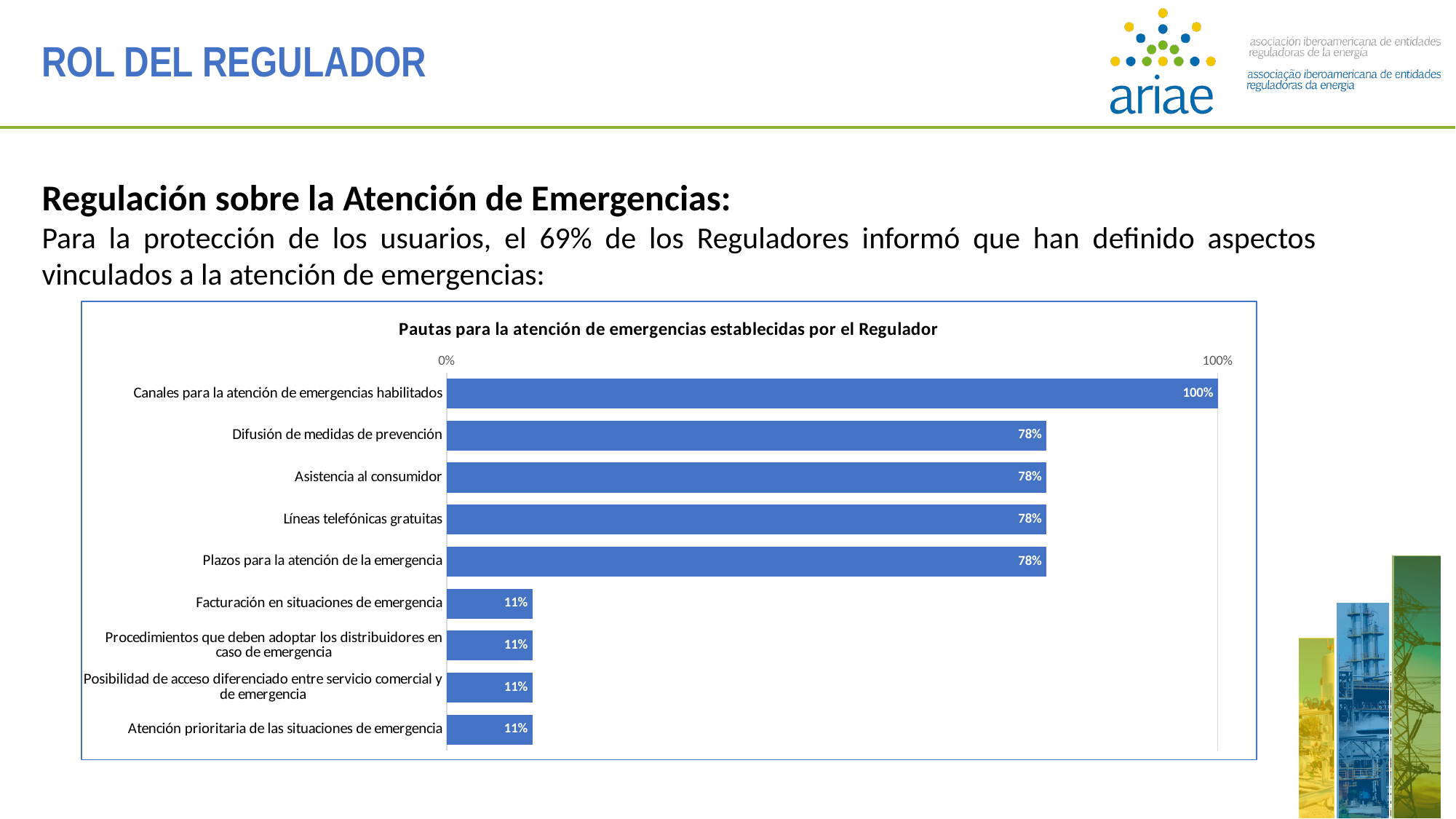
What is the value for "Canales para la atención de emergencias habilitados"? 100% How many categories have a value of 11%? 4 What is the title of the chart? Pautas para la atención de emergencias establecidas por el Regulador What is the value for "Facturación en situaciones de emergencia"? 11% What is the difference between the values for "Líneas telefónicas gratuitas" and "Atención prioritaria de las situaciones de emergencia"? 67% Which category has the highest value? Canales para la atención de emergencias habilitados How many categories are shown in the chart? 9 What is the value for "Plazos para la atención de la emergencia"? 78% Which is larger: the value for "Asistencia al consumidor" or the value for "Facturación en situaciones de emergencia"? Asistencia al consumidor What is the difference between the values for "Canales para la atención de emergencias habilitados" and "Asistencia al consumidor"? 22% What is the value for "Difusión de medidas de prevención"? 78% What kind of chart is shown on the slide? Bar chart